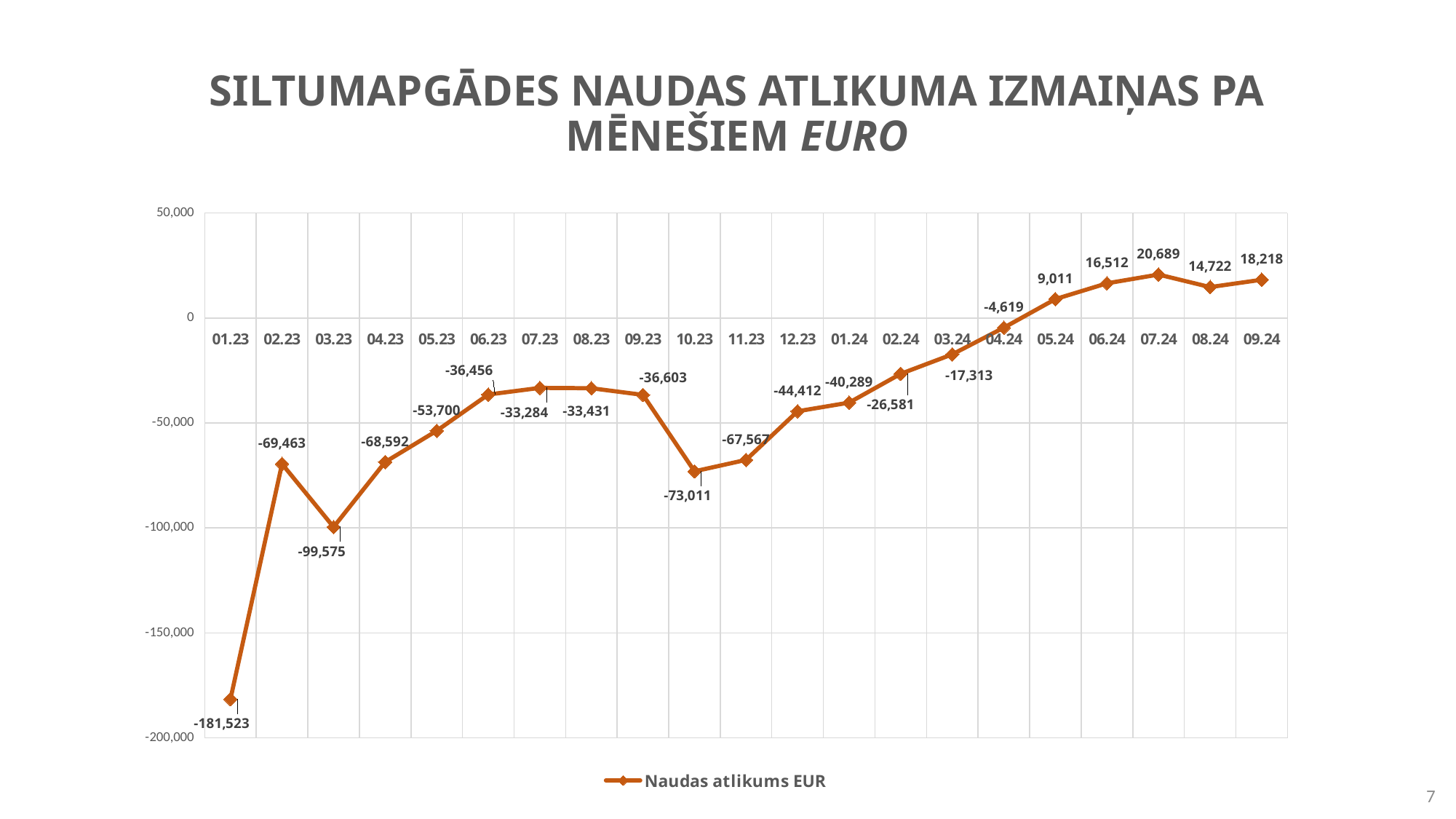
How many data points are plotted on the line? 21 How many series does the legend list? 1 Which month has the highest value? 07.24 What is the value for 01.23? -181,523 What is the difference between the values for 02.23 and 03.23? 30,112 What is the value for 05.24? 9,011 What is the value for 10.23? -73,011 What is the name of the series shown in the legend? Naudas atlikums EUR What is the difference between the values for 09.24 and 08.24? 3,496 What type of chart is shown on the slide? Line chart Which is larger, the value for 06.24 or the value for 08.24? 06.24 Which month has the lowest value? 01.23